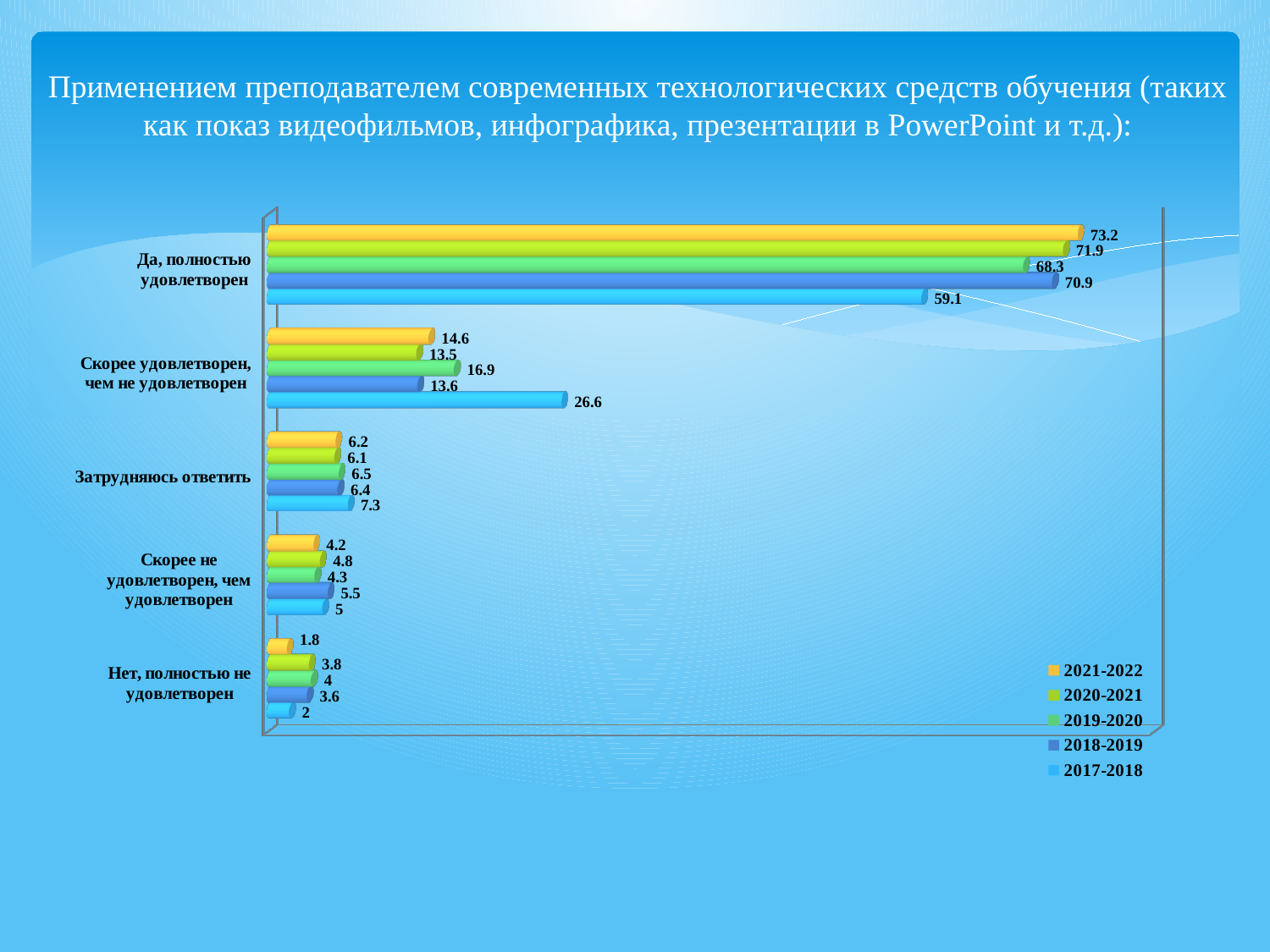
What is the value for "Скорее удовлетворен, чем не удовлетворен" in the 2017-2018 series? 26.6 How many categories are shown on the chart? 5 How many series does the legend list? 5 Which category has the lowest value in the 2021-2022 series? Нет, полностью не удовлетворен What kind of chart is shown on the slide? Bar chart What is the value for "Нет, полностью не удовлетворен" in the 2019-2020 series? 4 What is the value for "Да, полностью удовлетворен" in the 2021-2022 series? 73.2 Which category has the highest value in the 2021-2022 series? Да, полностью удовлетворен What is the value for "Затрудняюсь ответить" in the 2018-2019 series? 6.4 For "Скорее не удовлетворен, чем удовлетворен", which is larger: the 2018-2019 value or the 2017-2018 value? 2018-2019 What is the difference between the 2021-2022 and 2017-2018 values for "Да, полностью удовлетворен"? 14.1 Which series is shown in yellow in the legend? 2021-2022